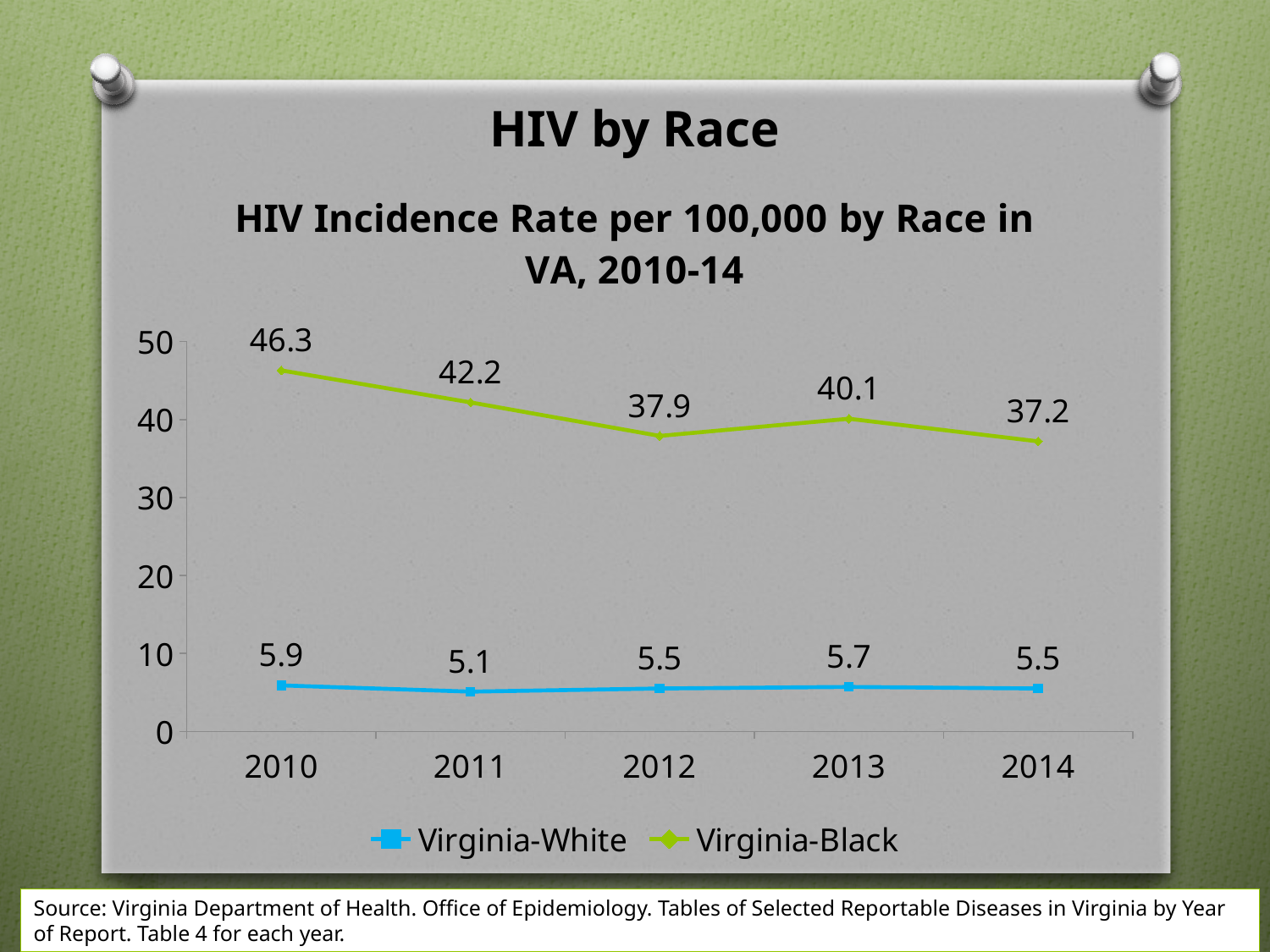
How many series does the legend list? 2 What is the HIV incidence rate for Virginia-Black in 2010? 46.3 What kind of chart is shown on the slide? line chart Which series has the higher rate in 2013, Virginia-White or Virginia-Black? Virginia-Black What is the HIV incidence rate for Virginia-White in 2013? 5.7 Does the Virginia-Black rate generally rise or fall from 2010 to 2014? fall What is the difference between the Virginia-Black and Virginia-White rates in 2012? 32.4 In which year is the Virginia-White rate lowest? 2011 How many years are shown on the x axis? 5 What is the HIV incidence rate for Virginia-Black in 2014? 37.2 Is the Virginia-Black rate in 2011 greater or less than 40? greater In which year is the Virginia-Black rate highest? 2010